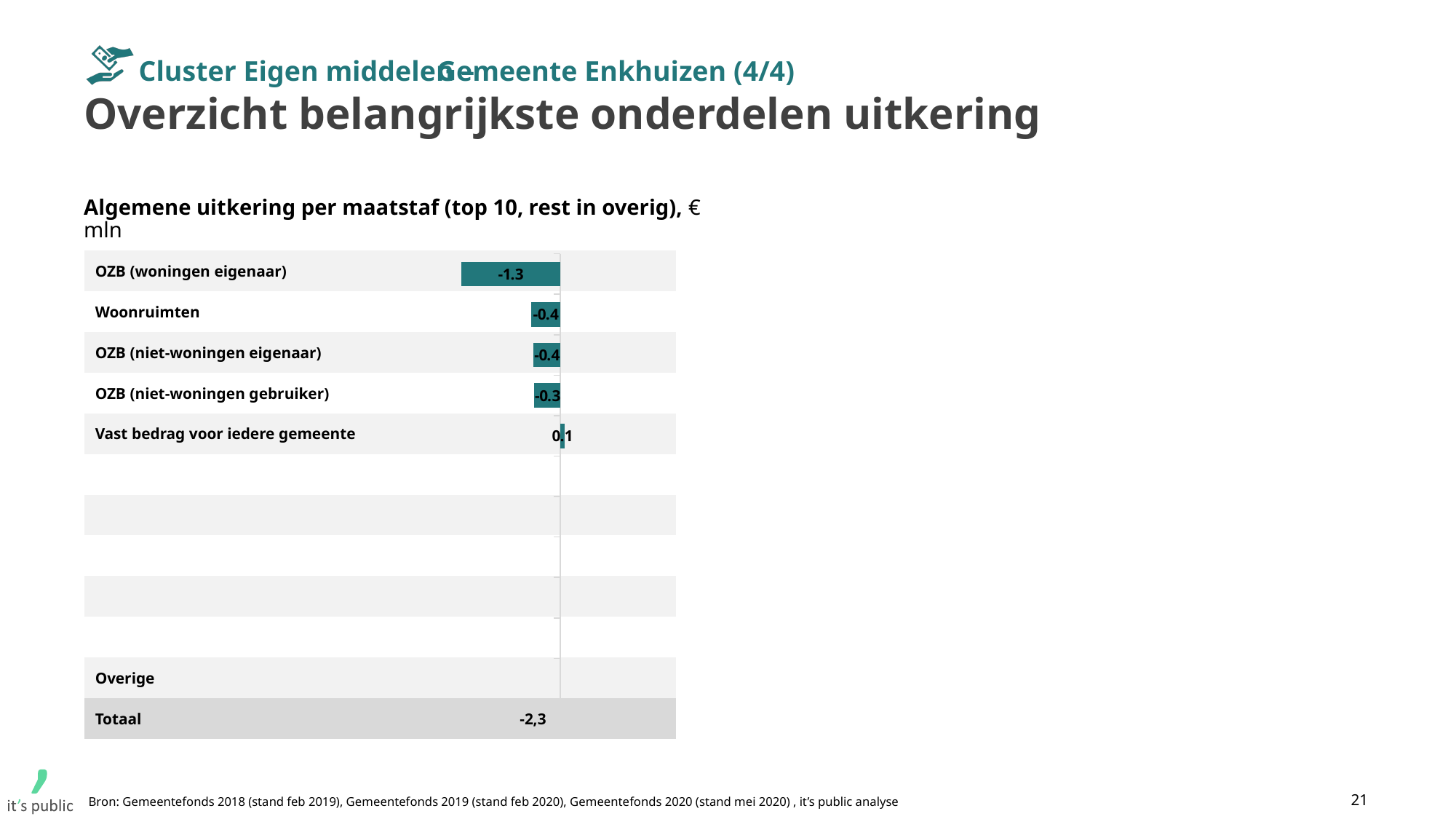
What is the value for Vast bedrag voor iedere gemeente? 0.1 How many categories have a bar plotted in the chart? 5 What is the difference between the values for OZB (woningen eigenaar) and Woonruimten? 0.9 What is the value for Woonruimten? -0.4 Which is larger, the value for Woonruimten or the value for OZB (niet-woningen gebruiker)? OZB (niet-woningen gebruiker) In what unit are the values in the chart expressed, according to the chart title? € mln What is the value shown for Totaal? -2,3 What is the value for OZB (niet-woningen gebruiker)? -0.3 What is the value for OZB (woningen eigenaar)? -1.3 Which category has the lowest value? OZB (woningen eigenaar) What kind of chart is shown on the slide? Bar chart Which category has the highest value? Vast bedrag voor iedere gemeente